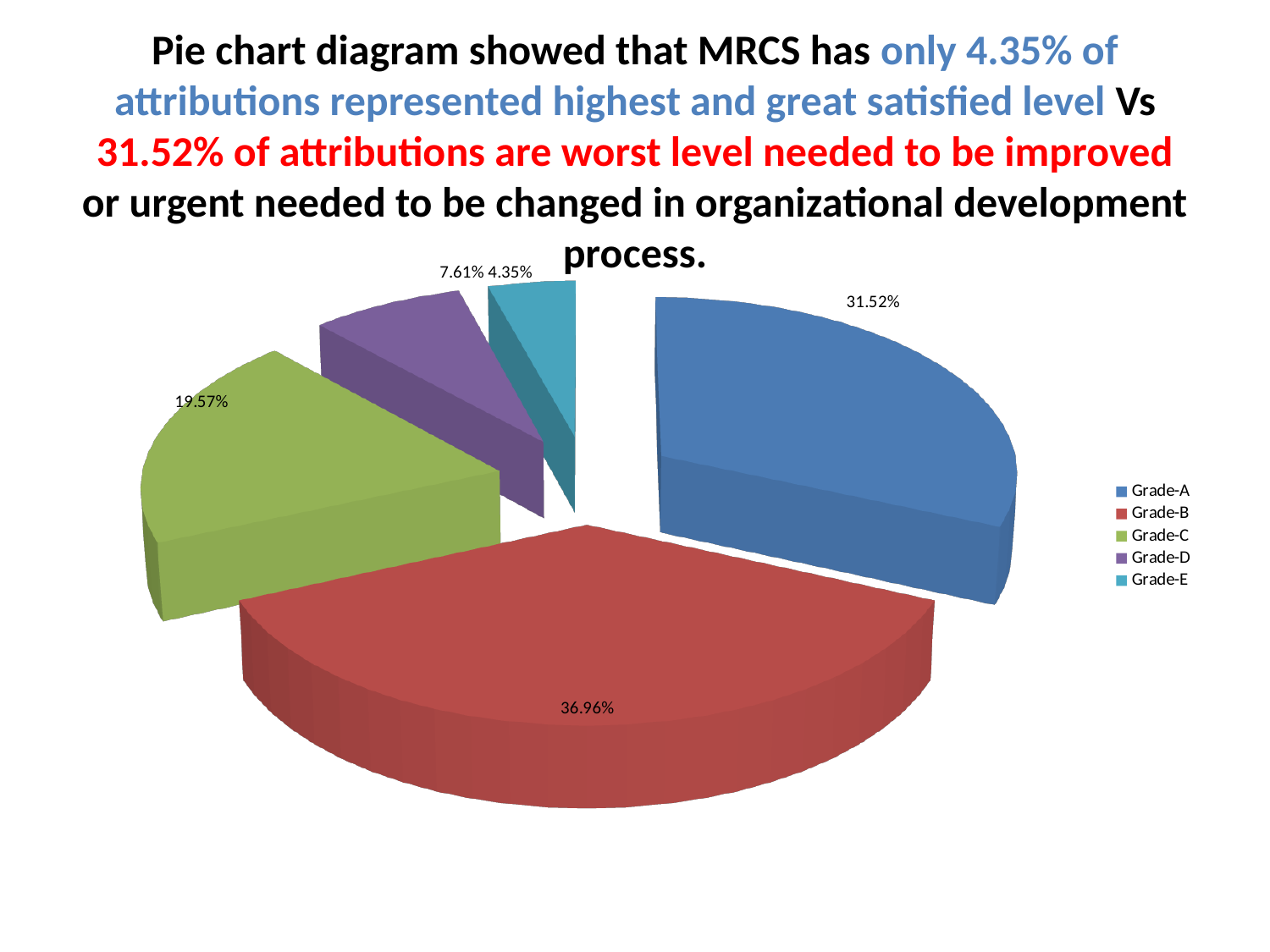
Which grade has the largest slice of the pie? Grade-B What is the value shown for Grade-D? 7.61% Which grade has the smallest slice of the pie? Grade-E What share of the pie does Grade-E represent? 4.35% What is the value shown for Grade-B? 36.96% What colour is the Grade-A slice in the pie chart? Blue What is the value shown for Grade-C? 19.57% Which is larger, the slice for Grade-C or the slice for Grade-D? Grade-C What percentage of the pie does Grade-A represent? 31.52% How many slices does the pie chart have? 5 What is the difference in percentage points between Grade-B and Grade-A? 5.44 What type of chart is shown on the slide? Pie chart